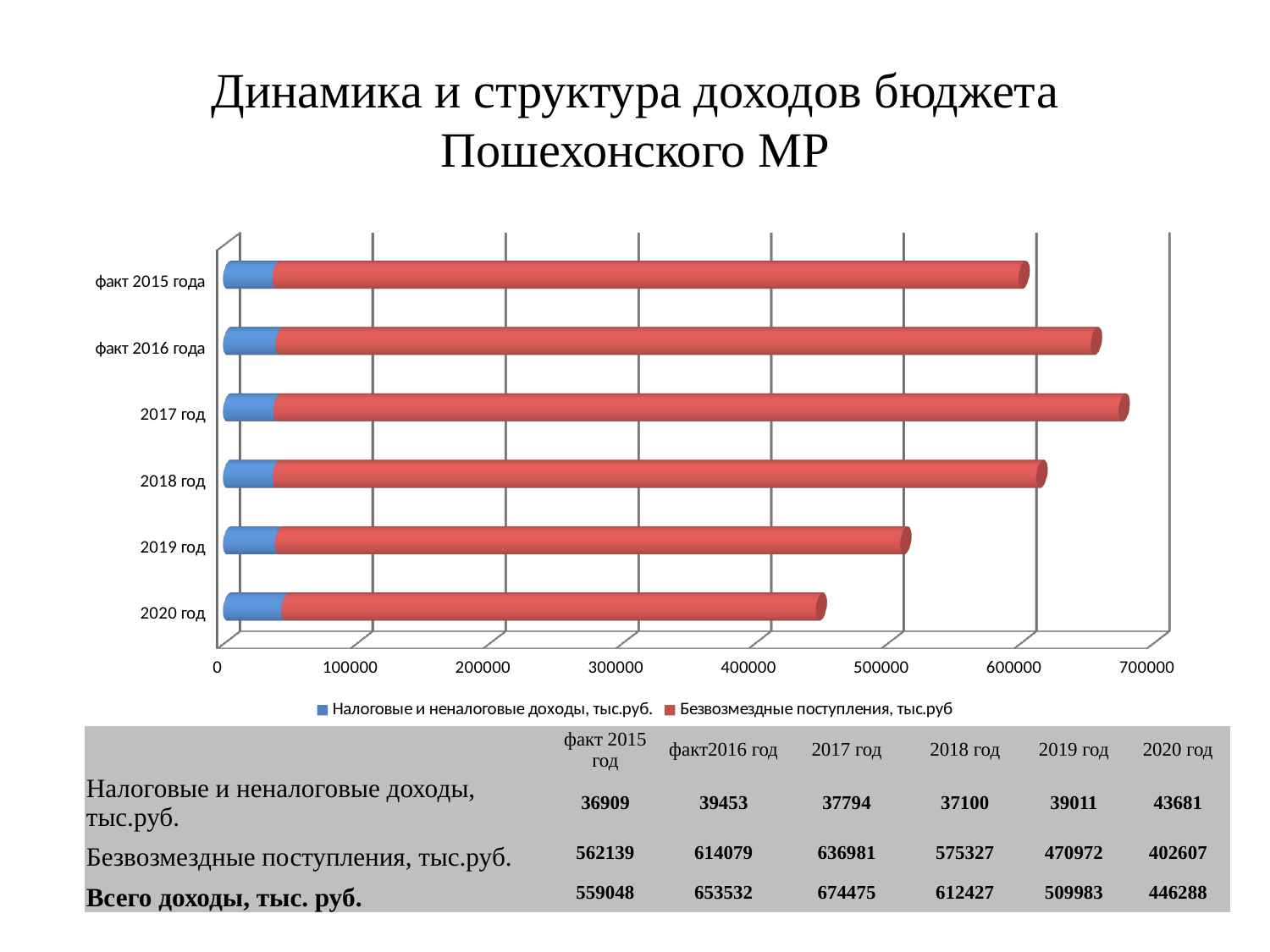
Which year has the lowest value for Безвозмездные поступления, тыс.руб? 2020 год What is the total of the stacked bar for 2018 год? 612427 Which is larger, Безвозмездные поступления for факт 2016 года or for 2018 год? факт 2016 года What is the value of Налоговые и неналоговые доходы, тыс.руб. for 2020 год? 43681 How many series does the chart legend list? 2 What kind of chart is shown on the slide? bar chart Which year has the highest value for Налоговые и неналоговые доходы, тыс.руб.? 2020 год Which year has the highest value for Безвозмездные поступления, тыс.руб? 2017 год How many categories (years) are plotted on the chart? 6 What is the difference between Безвозмездные поступления for 2019 год and 2020 год? 68365 What is the value of Безвозмездные поступления, тыс.руб for 2017 год? 636981 Is the total length of the stacked bar for 2020 год greater or less than 500000? less